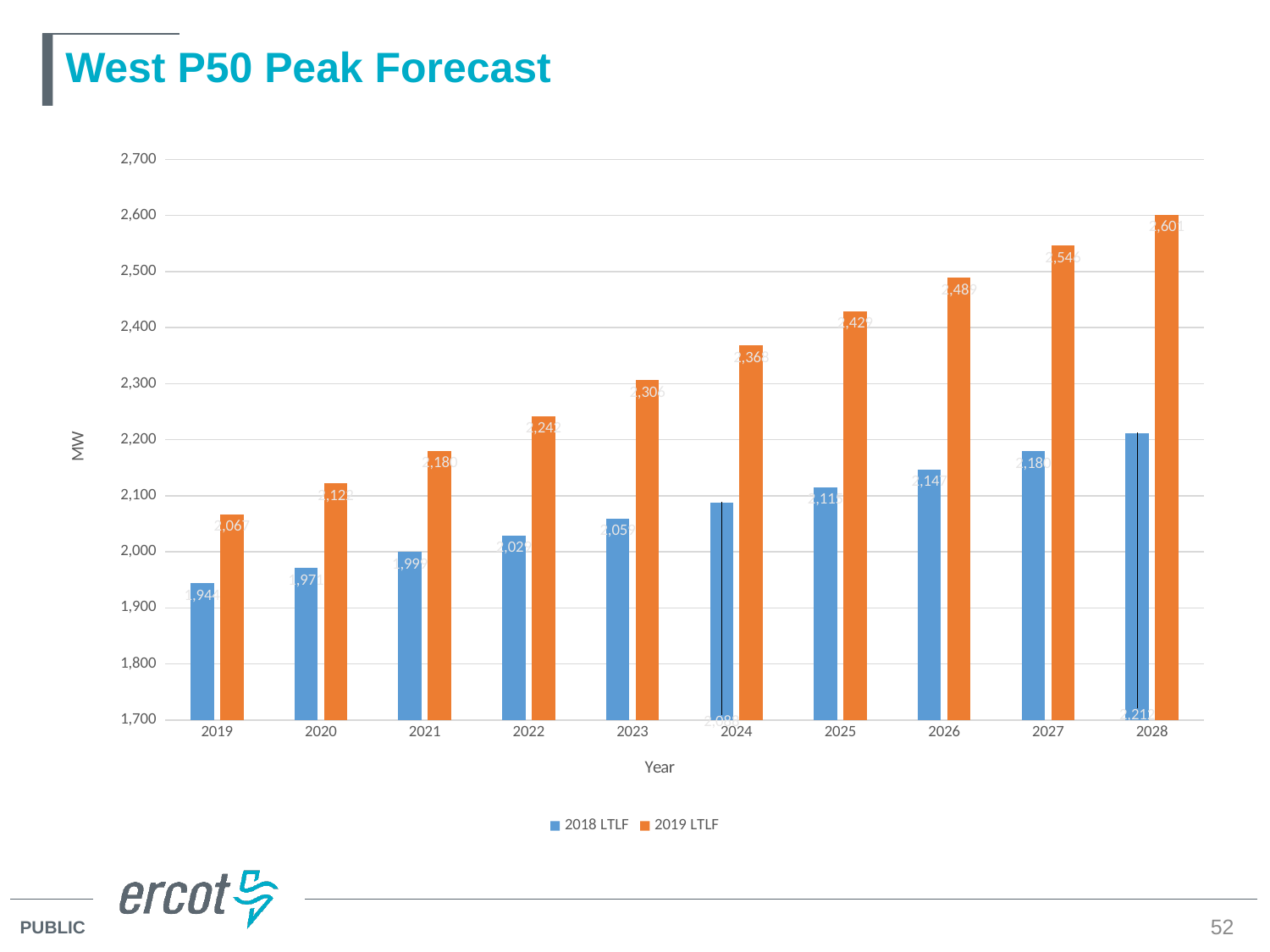
For 2025, which series has the larger value, 2018 LTLF or 2019 LTLF? 2019 LTLF Is the 2019 LTLF value for 2027 greater or less than 2,500? greater Is the 2018 LTLF value for 2019 greater or less than 2,000? less What type of chart is shown on the slide? bar chart Which year has the highest 2019 LTLF value? 2028 Do the 2019 LTLF values rise or fall from 2019 to 2028? rise How many years are shown on the x axis? 10 What is the label of the y axis? MW What is the title of the chart? West P50 Peak Forecast Is the 2018 LTLF value for 2024 greater or less than 2,100? less How many series does the legend list? 2 Which year has the lowest 2018 LTLF value? 2019